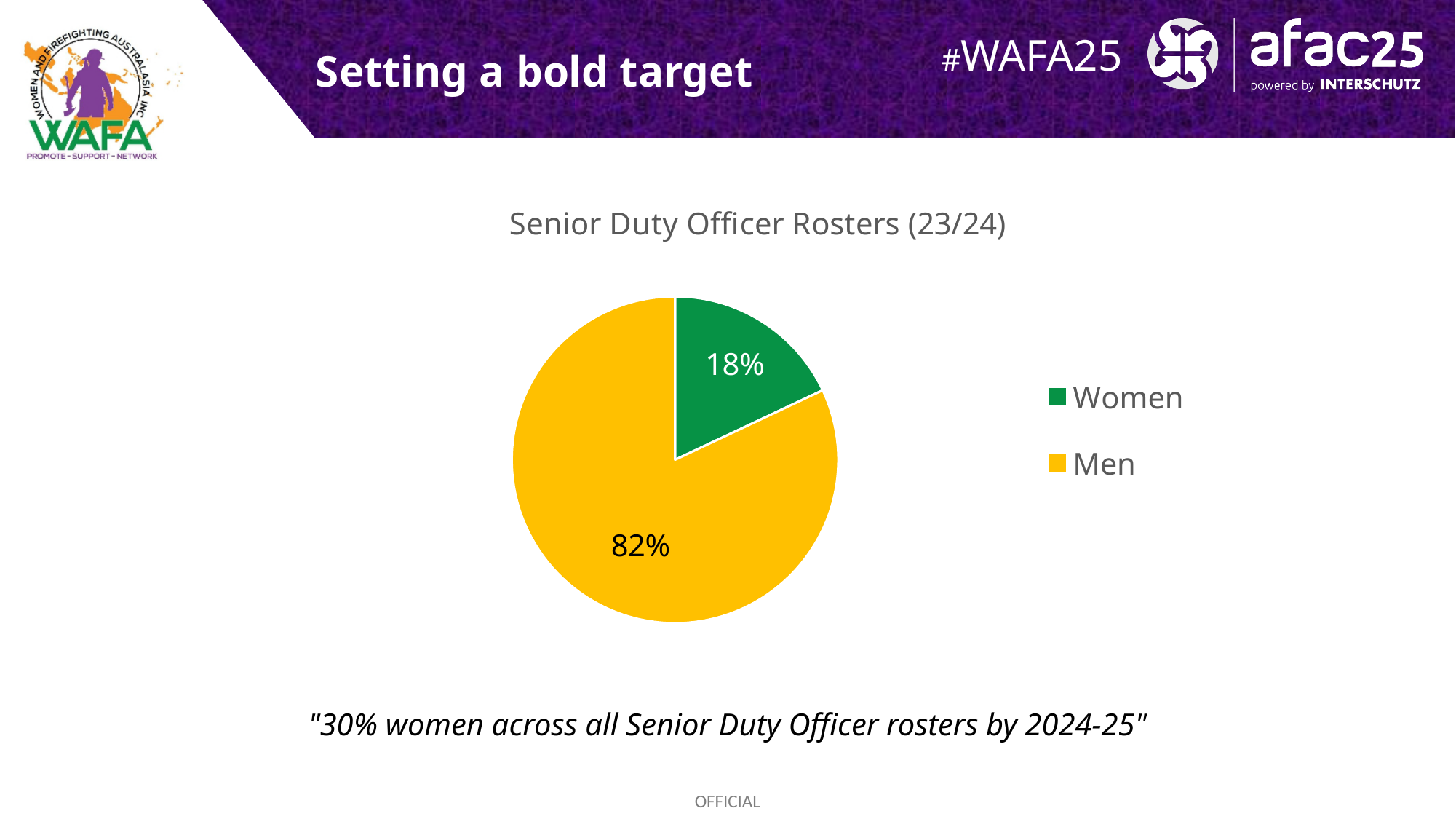
What colour is the Women slice? Green What share of the pie does the Women slice represent? 18% What is the difference in percentage points between the Men and Women slices? 64 What percentage of the pie is labelled for Men? 82% How many categories does the legend list? 2 What percentage of the pie is labelled for Women? 18% Which category has the smallest slice of the pie? Women What is the title of the chart? Senior Duty Officer Rosters (23/24) Which slice is larger, Women or Men? Men Which category has the largest slice of the pie? Men What kind of chart is shown on the slide? Pie chart